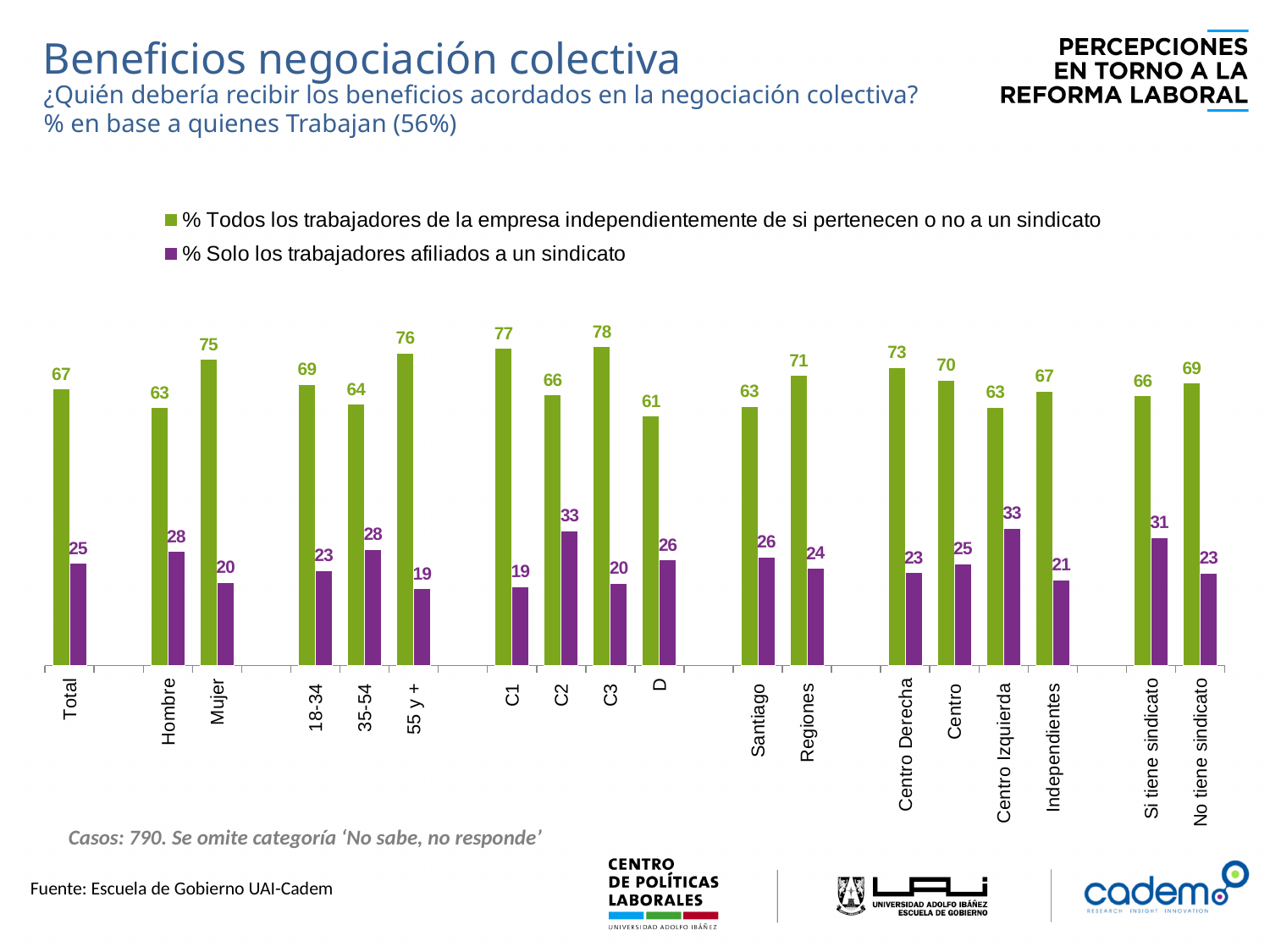
What colour are the bars for the series '% Solo los trabajadores afiliados a un sindicato'? Purple What is the value for Centro Izquierda in the series '% Solo los trabajadores afiliados a un sindicato'? 33 How many series does the legend list? 2 What is the value for Total in the series '% Todos los trabajadores de la empresa independientemente de si pertenecen o no a un sindicato'? 67 Which is larger: the '% Solo los trabajadores afiliados a un sindicato' value for Si tiene sindicato or for No tiene sindicato? Si tiene sindicato What kind of chart is shown on the slide? Bar chart How many categories are shown on the x axis of the chart? 18 Which category has the highest value in the series '% Todos los trabajadores de la empresa independientemente de si pertenecen o no a un sindicato'? C3 What is the difference between the '% Todos los trabajadores...' value and the '% Solo los trabajadores afiliados a un sindicato' value for Santiago? 37 Which is larger: the '% Todos los trabajadores...' value for Hombre or for Mujer? Mujer Which category has the lowest value in the series '% Todos los trabajadores de la empresa independientemente de si pertenecen o no a un sindicato'? D What is the value for Mujer in the series '% Solo los trabajadores afiliados a un sindicato'? 20